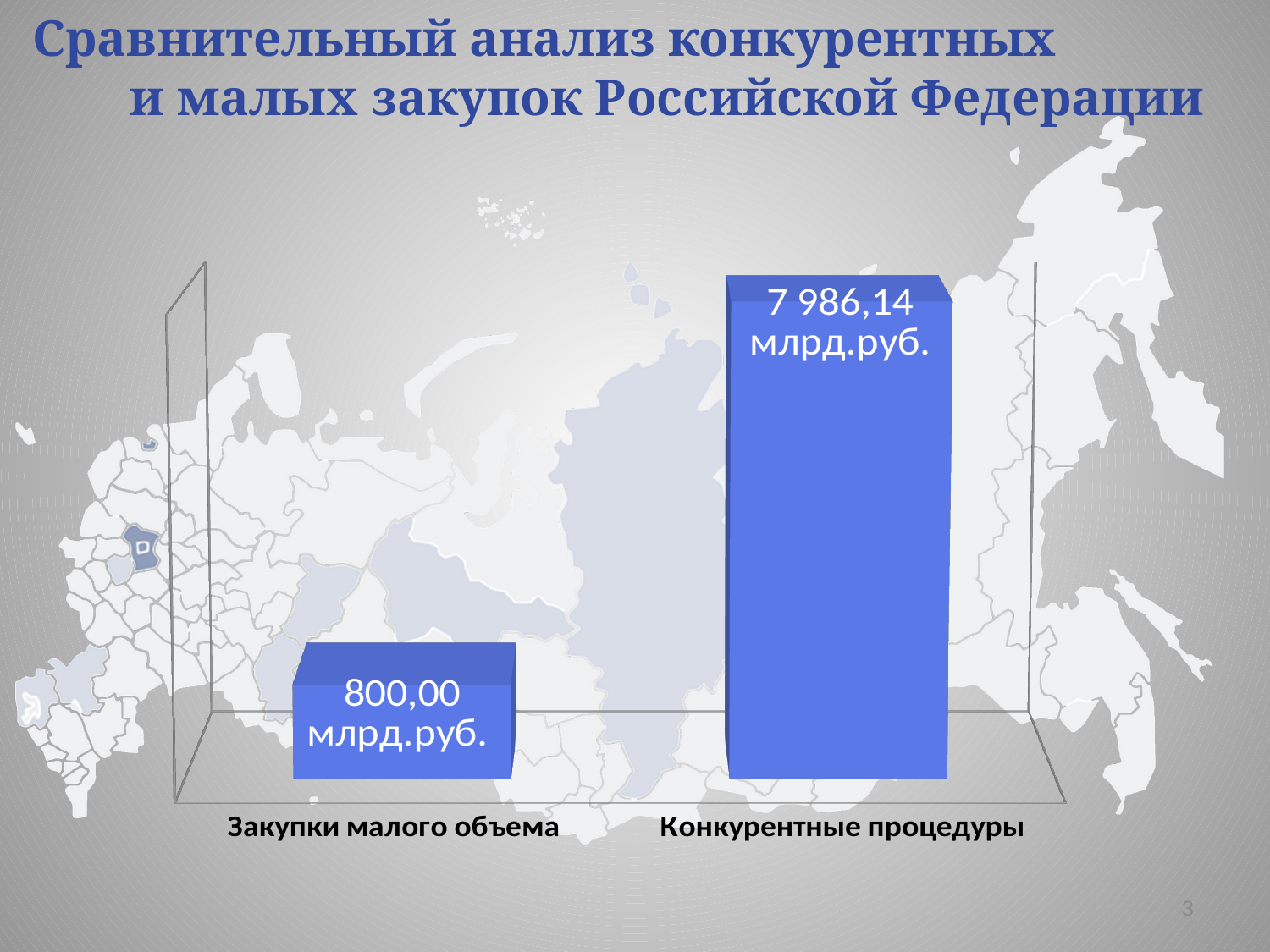
What kind of chart is shown on the slide? Bar chart What colour are the bars in the chart? Blue What is the value for Конкурентные процедуры? 7 986,14 млрд.руб. What is the difference between the values for Конкурентные процедуры and Закупки малого объема? 7 186,14 млрд.руб. What is the title of the slide? Сравнительный анализ конкурентных и малых закупок Российской Федерации Which category has the highest value? Конкурентные процедуры What is the value for Закупки малого объема? 800,00 млрд.руб. Which is larger: the value for Закупки малого объема or the value for Конкурентные процедуры? Конкурентные процедуры How many categories are shown in the chart? 2 Which category has the lowest value? Закупки малого объема